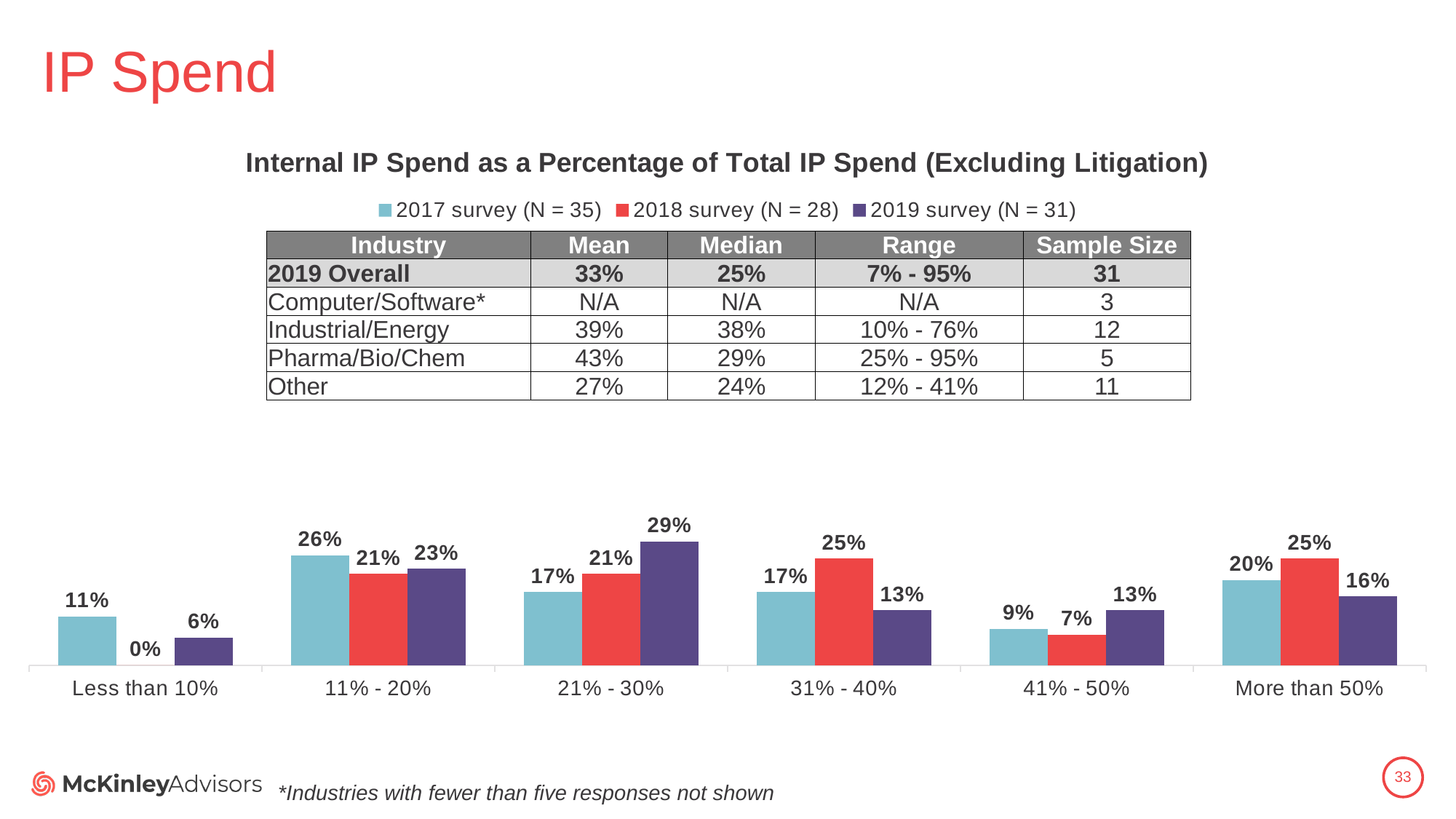
Which is larger in the More than 50% category: the 2017 survey value or the 2018 survey value? 2018 survey Which category has the lowest value for the 2018 survey? Less than 10% What is the value for the 2019 survey in the 21% - 30% category? 29% What is the value for the 2017 survey in the Less than 10% category? 11% What is the sample size for the 2019 survey according to the legend? 31 How many series does the chart legend list? 3 What is the title of the chart? Internal IP Spend as a Percentage of Total IP Spend (Excluding Litigation) What is the difference between the 2018 survey and 2019 survey values in the 31% - 40% category? 12% How many categories are shown on the x axis of the chart? 6 What is the value for the 2018 survey in the 41% - 50% category? 7% Which category has the highest value for the 2017 survey? 11% - 20% What kind of chart is shown on the slide? Bar chart